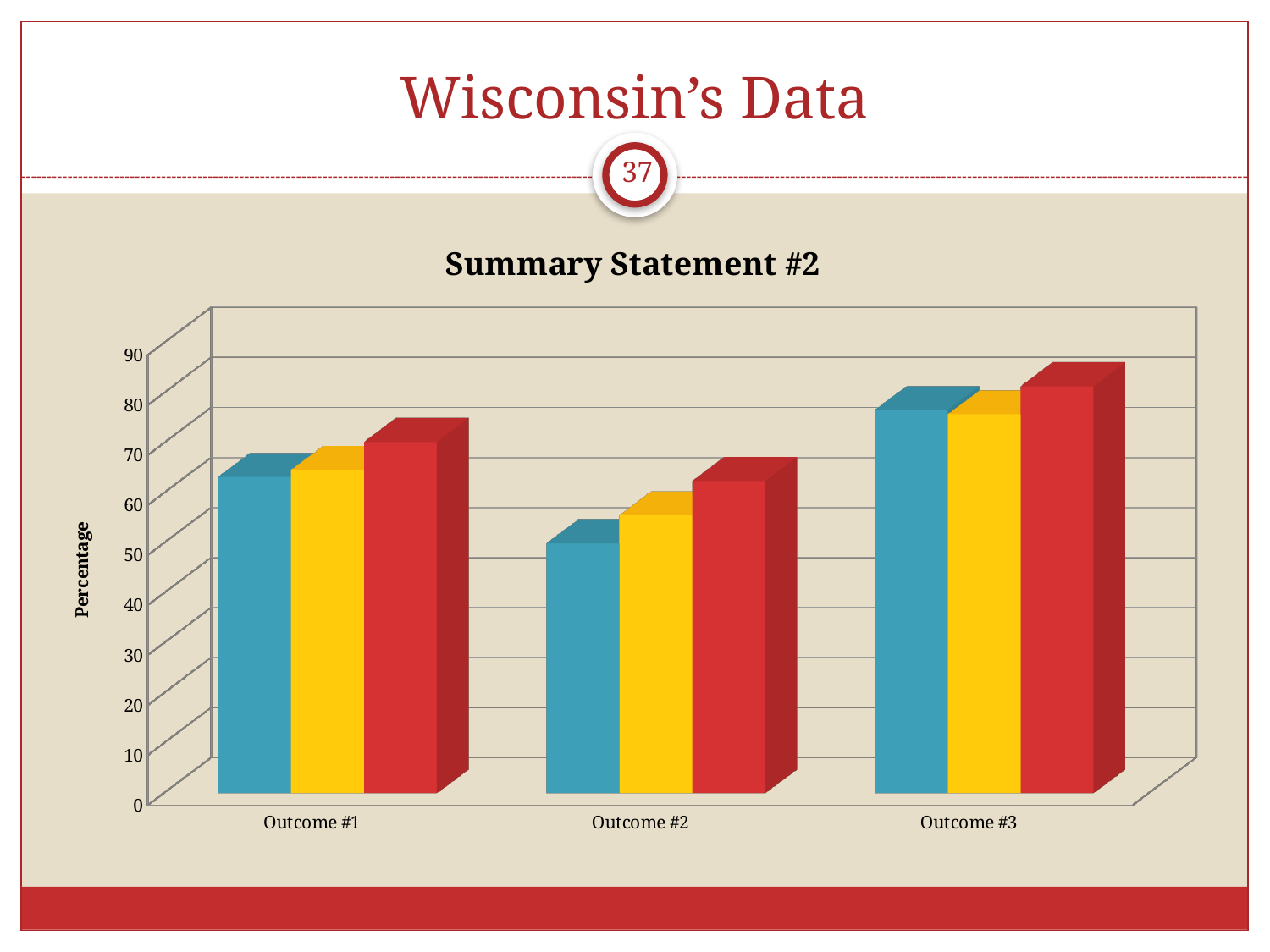
What is the title of the chart? Summary Statement #2 For Outcome #2, which is larger: the red bar or the blue bar? The red bar Is the value of the red bar for Outcome #3 greater or less than 70? greater Which outcome category has the tallest bars overall? Outcome #3 Which outcome category has the shortest bars overall? Outcome #2 How many bars are plotted for each outcome category? 3 How many categories are shown on the x axis of the chart? 3 What is the label on the vertical axis of the chart? Percentage Is the value of the red bar for Outcome #1 greater or less than 60? greater What kind of chart is shown on the slide? Bar chart Is the value of the blue bar for Outcome #1 greater or less than 70? less